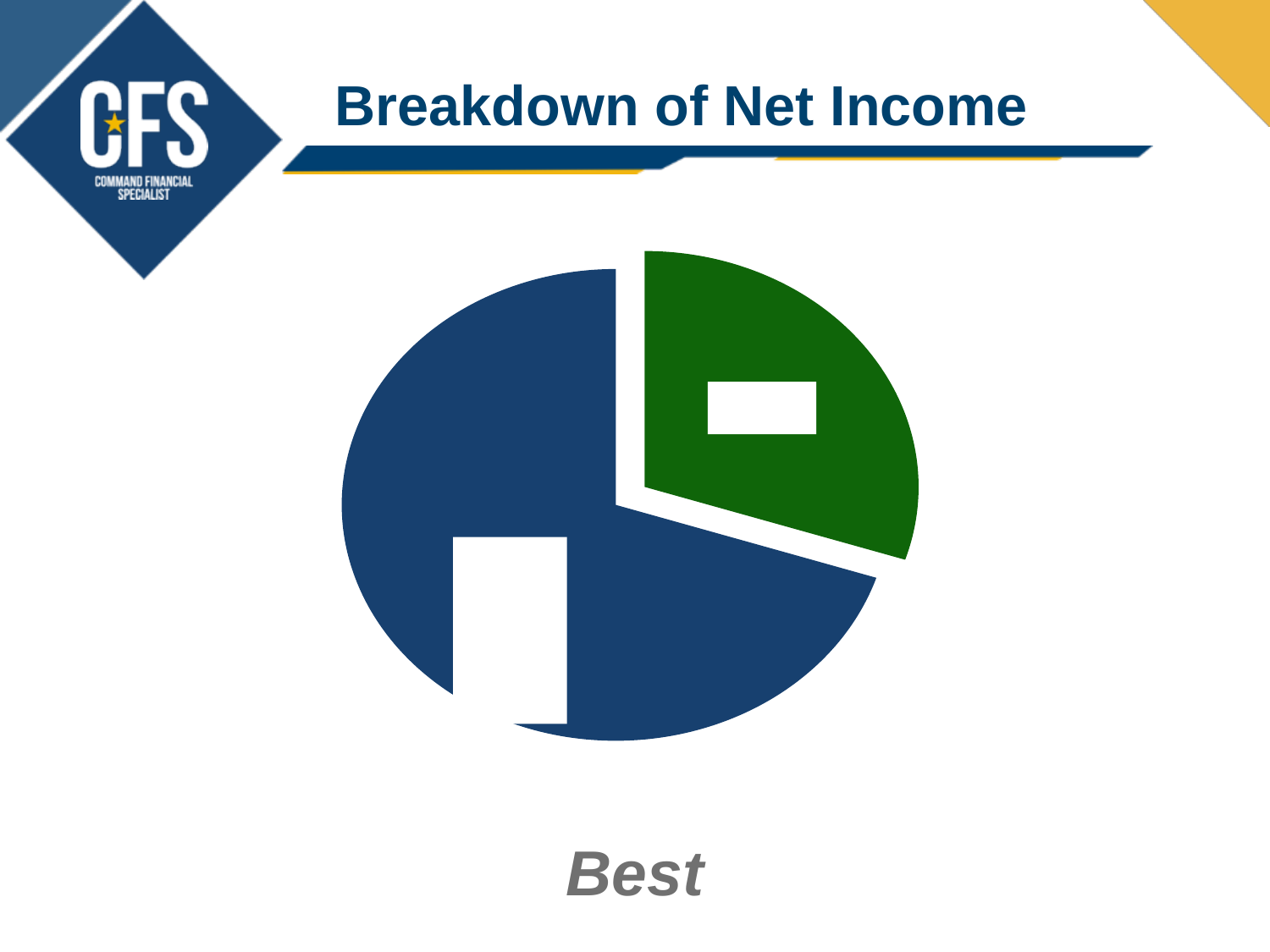
Which colour slice takes up the smallest share of the pie chart? Green Does the blue slice represent more or less than half of the pie chart? More What two colours are used for the slices of the pie chart? Blue and green What is the title of the slide containing the pie chart? Breakdown of Net Income What kind of chart is shown on the slide? Pie chart Which colour slice takes up the largest share of the pie chart? Blue How many slices does the pie chart have? 2 Which slice of the pie chart is larger, the blue one or the green one? The blue one